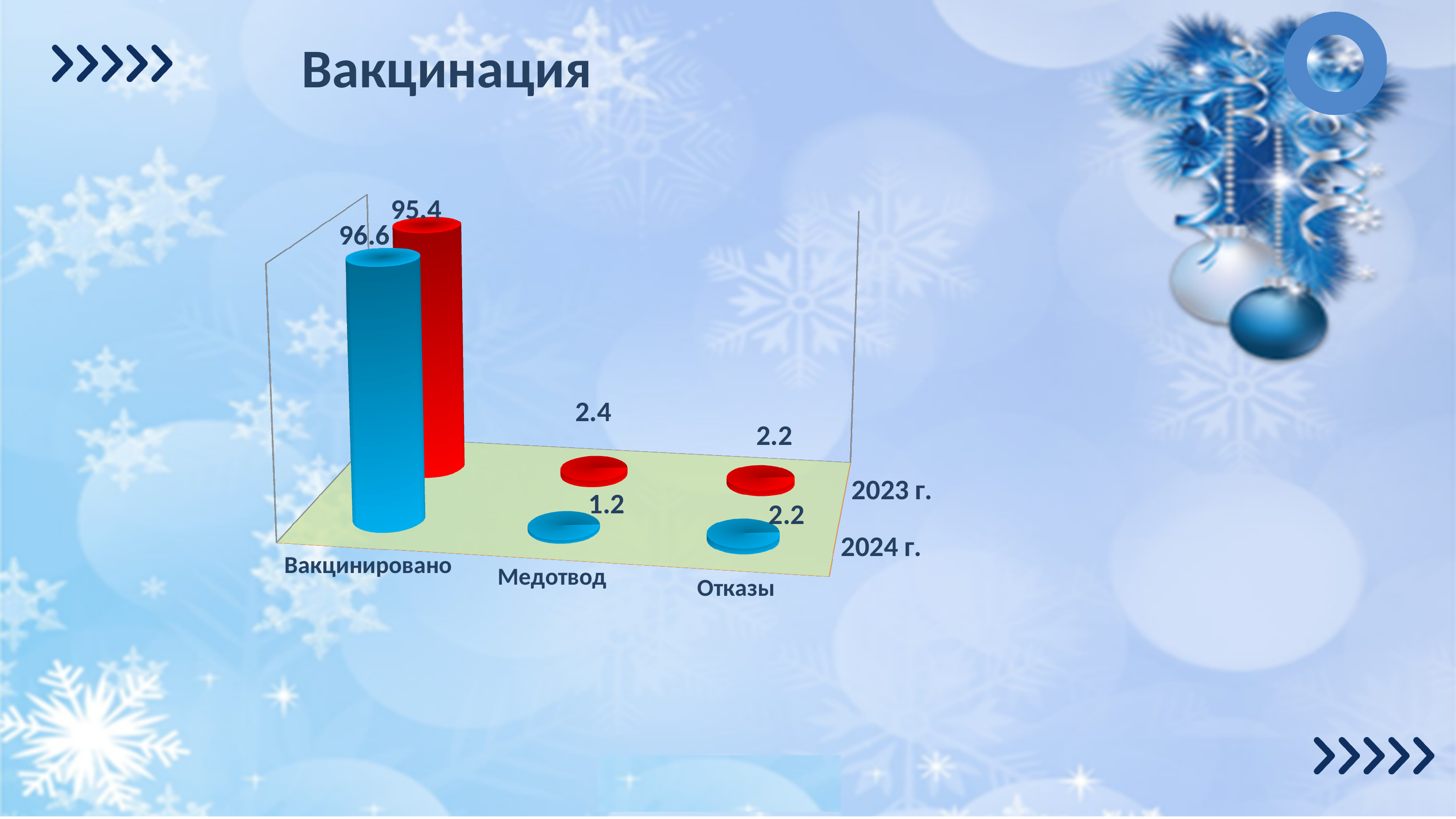
How many categories are shown on the chart? 3 What is the difference between the Вакцинировано values for 2024 г. and 2023 г.? 1.2 What is the value for Медотвод in 2023 г.? 2.4 What type of chart is shown on the slide? Bar chart Which is larger, the Медотвод value for 2023 г. or for 2024 г.? 2023 г. What is the value for Вакцинировано in 2024 г.? 96.6 What is the value for Вакцинировано in 2023 г.? 95.4 Which category has the highest value in 2024 г.? Вакцинировано What is the value for Медотвод in 2024 г.? 1.2 Which category has the lowest value in 2024 г.? Медотвод What is the difference between the Медотвод values for 2023 г. and 2024 г.? 1.2 What is the value for Отказы in 2023 г.? 2.2